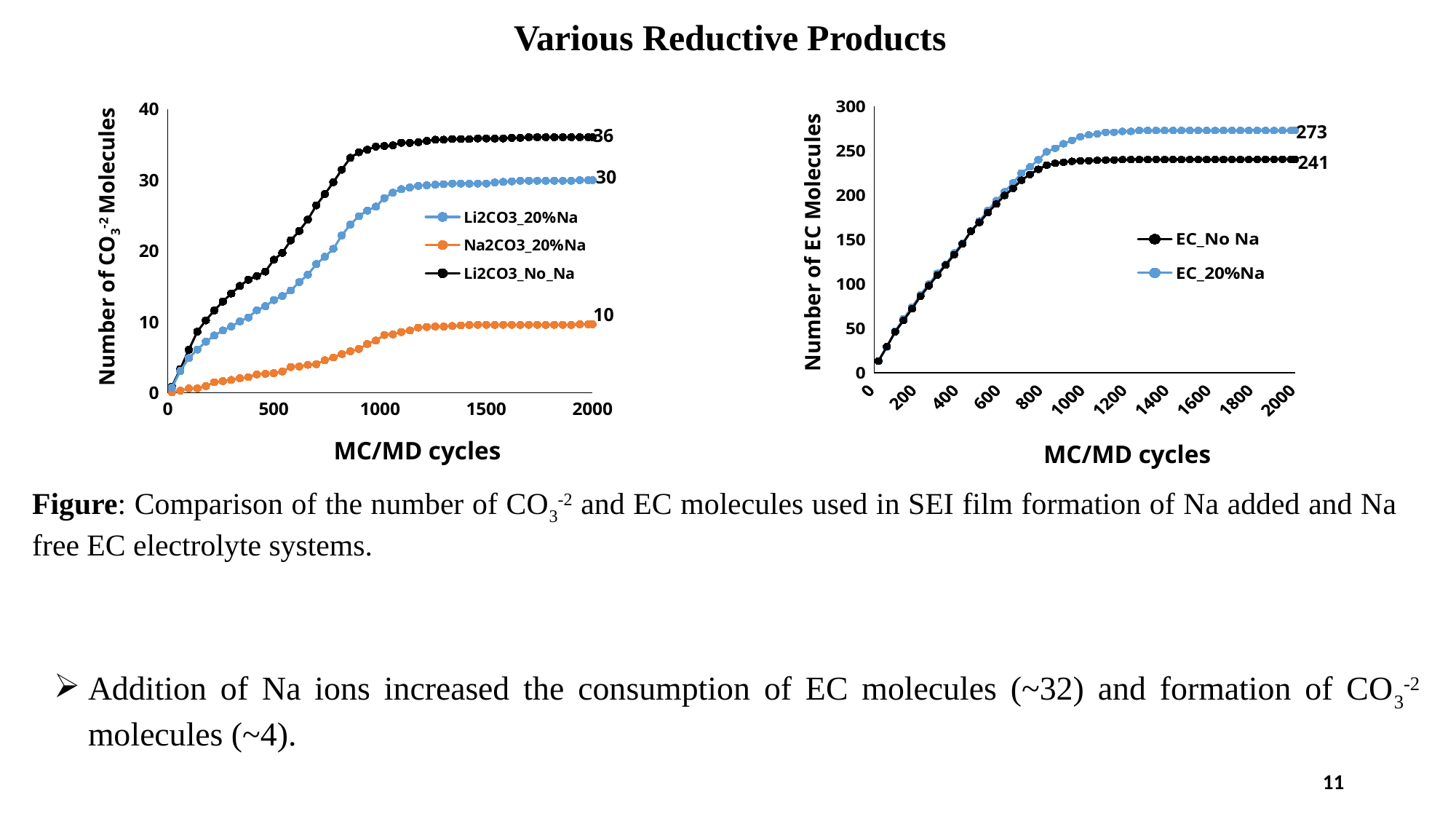
In the left chart (Number of CO3-2 Molecules), what is the difference between the final values of Li2CO3_No_Na and Li2CO3_20%Na? 6 In the left chart (Number of CO3-2 Molecules), what is the final labelled value of the Na2CO3_20%Na series? 10 What kind of chart is the right chart (Number of EC Molecules)? Line chart In the left chart (Number of CO3-2 Molecules), what is the final labelled value of the Li2CO3_No_Na series at 2000 cycles? 36 In the right chart (Number of EC Molecules), what is the difference between the final values of EC_20%Na and EC_No Na? 32 In the right chart (Number of EC Molecules), what is the final labelled value of the EC_No Na series? 241 In the left chart (Number of CO3-2 Molecules), what is the final labelled value of the Li2CO3_20%Na series? 30 How many series does the legend of the left chart (Number of CO3-2 Molecules) list? 3 In the right chart (Number of EC Molecules), do the values rise or fall as MC/MD cycles increase? Rise In the right chart (Number of EC Molecules), which series has the higher final value, EC_No Na or EC_20%Na? EC_20%Na In the right chart (Number of EC Molecules), what is the final labelled value of the EC_20%Na series? 273 In the left chart (Number of CO3-2 Molecules), which series reaches the lowest final value? Na2CO3_20%Na